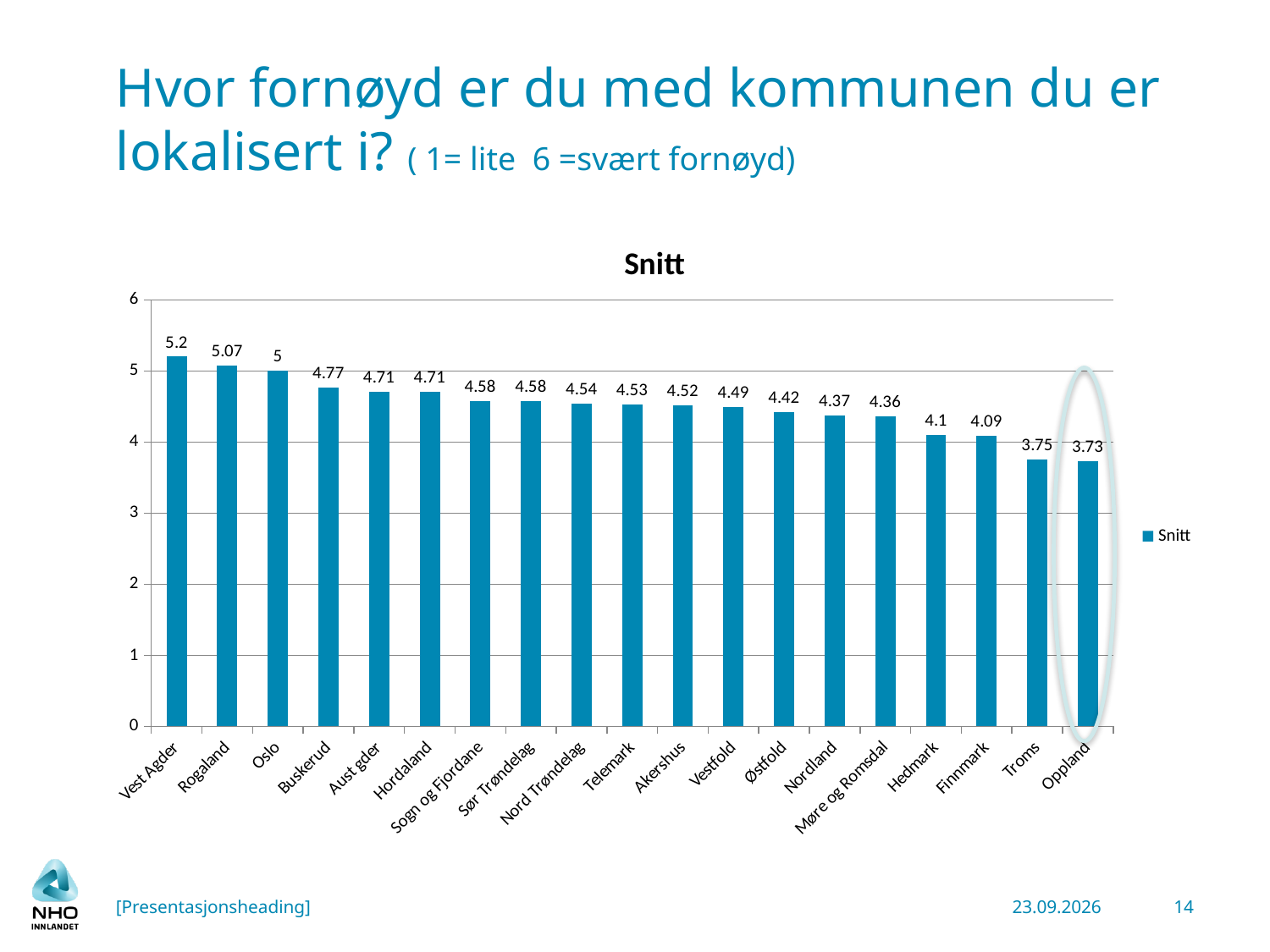
Is the value for Troms greater or less than 4? less What is the value for Oppland? 3.73 Which category has the lowest value? Oppland How many categories are shown on the x axis? 19 What is the value for Hedmark? 4.1 What kind of chart is shown on the slide? bar chart What is the value for Møre og Romsdal? 4.36 What is the value for Vest Agder? 5.2 Which is larger, the value for Buskerud or the value for Østfold? Buskerud What is the difference between the values for Vest Agder and Oppland? 1.47 How many series does the legend list? 1 Which category has the highest value? Vest Agder